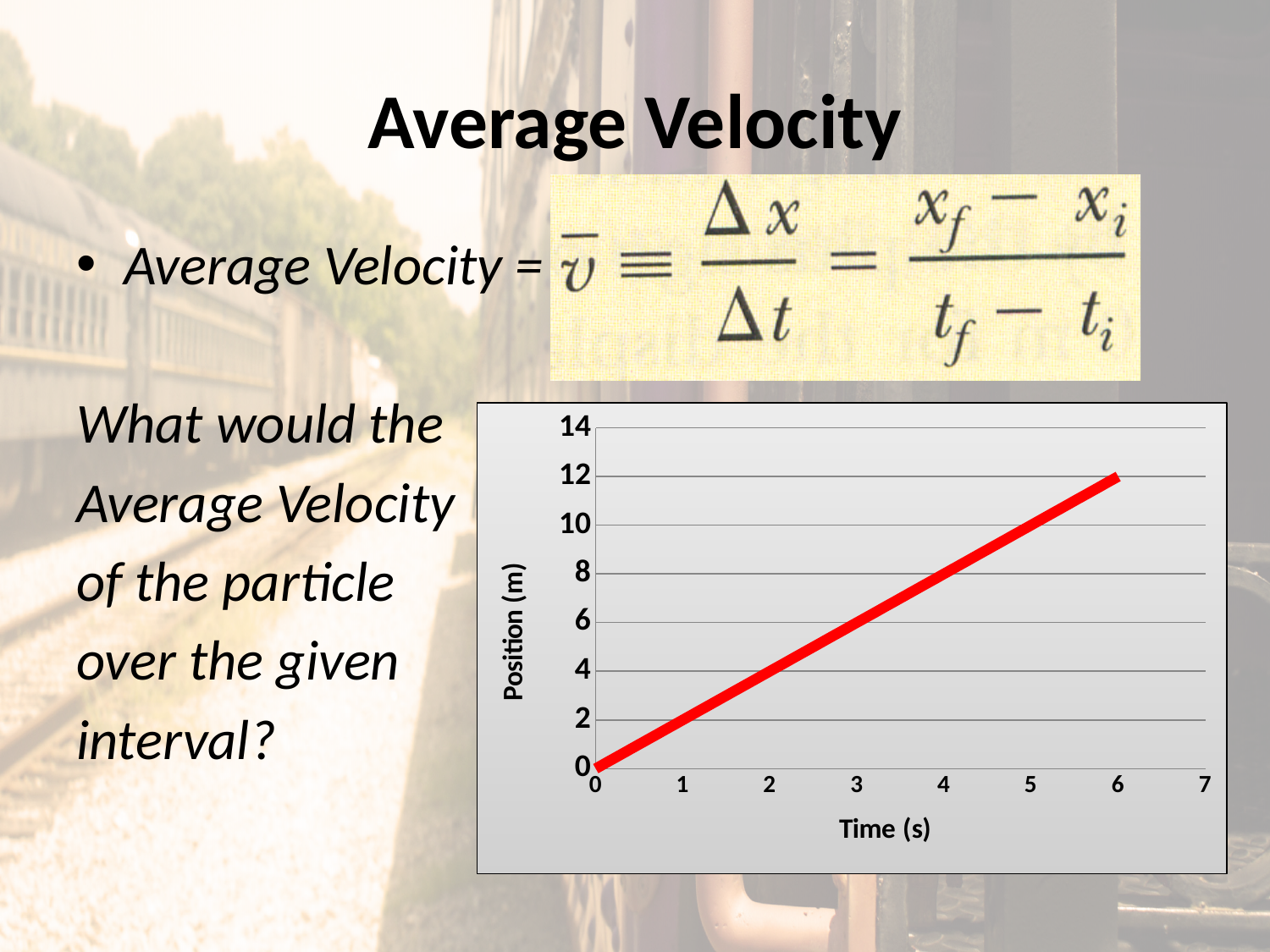
Is the position at time 1 s greater or less than 4? less What is the position at time 6 s? 12 What is the label of the y axis of the chart? Position (m) At which time does the line reach its highest position? 6 At which time is the position lowest? 0 Does the position rise or fall as time increases along the x axis? rise What kind of chart is shown on the slide? line chart What is the label of the x axis of the chart? Time (s) Is the position at time 2 s greater or less than 6? less By how much does the position change between time 0 s and time 6 s? 12 What is the position at time 0 s? 0 Is the position at time 5 s greater or less than 8? greater